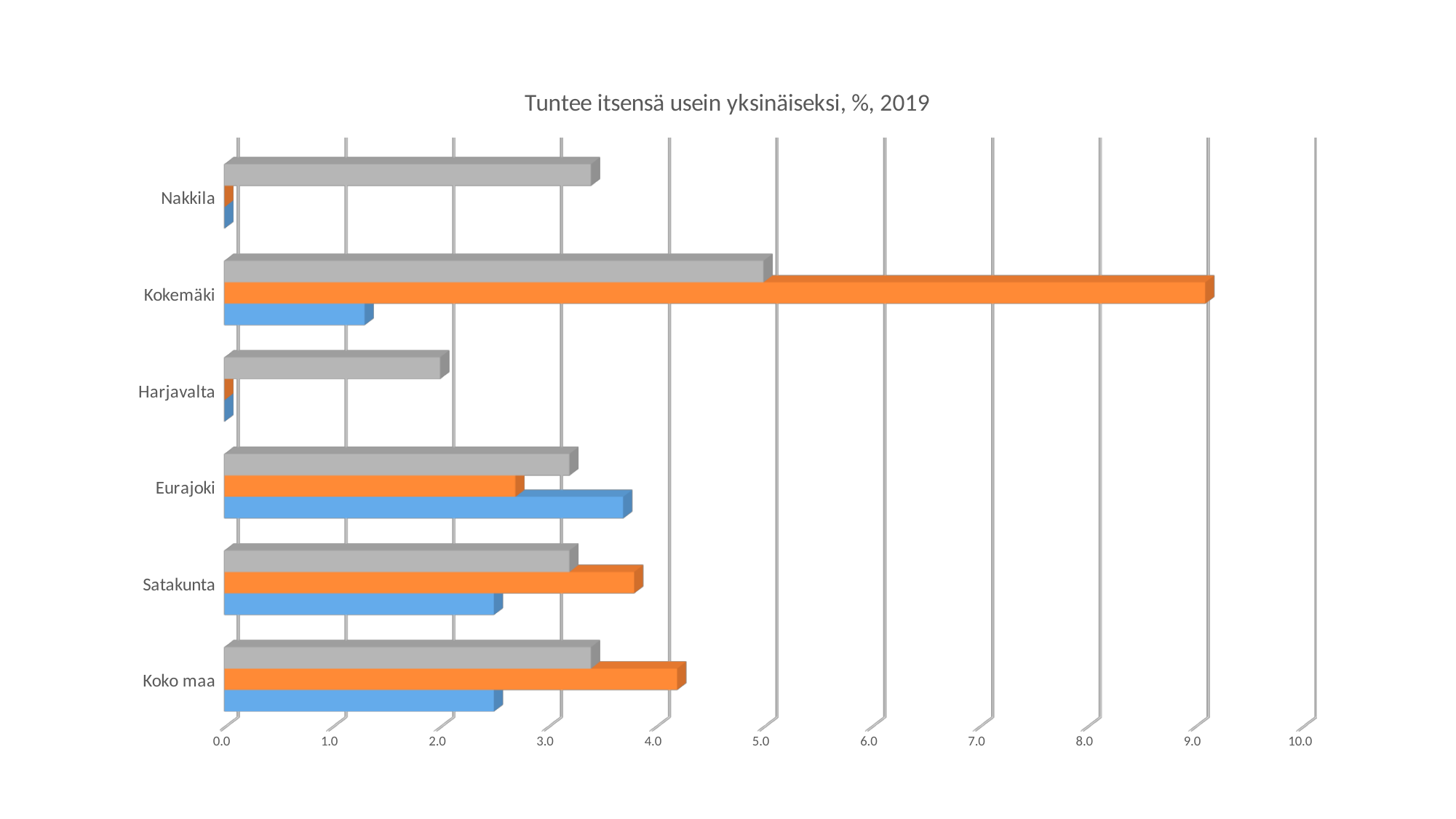
Is the value of the blue bar for Koko maa greater or less than 3.0? less Is the value of the gray bar for Nakkila greater or less than 3.0? greater How many categories are shown on the vertical axis of the chart? 6 Is the value of the gray bar for Harjavalta greater or less than 3.0? less For Satakunta, which is larger: the orange bar or the blue bar? the orange bar Which category has the longest orange bar? Kokemäki For Eurajoki, which is larger: the blue bar or the orange bar? the blue bar Which category has the longest gray bar? Kokemäki What is the title of the chart? Tuntee itsensä usein yksinäiseksi, %, 2019 What kind of chart is shown on the slide? bar chart